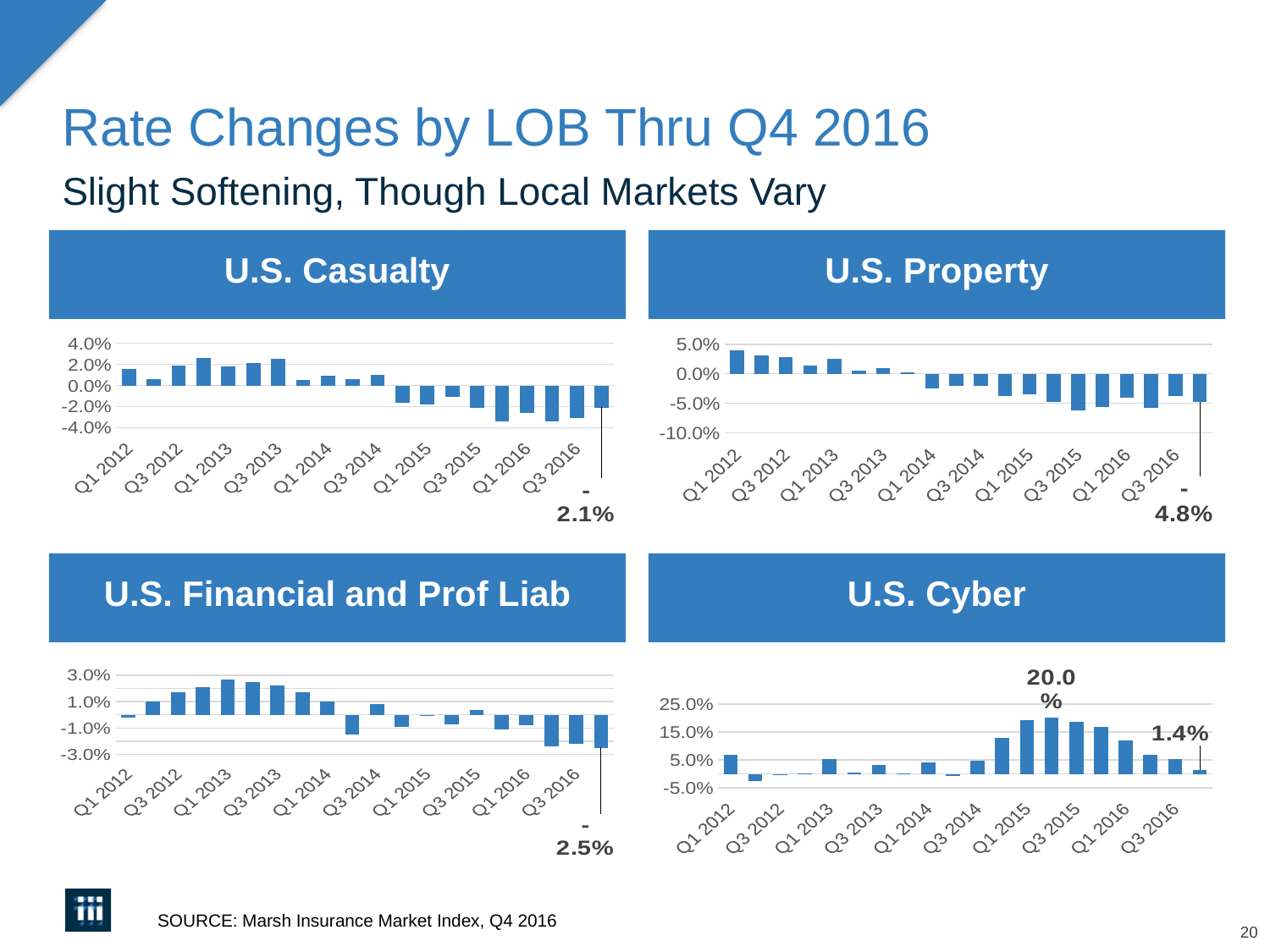
On the U.S. Property chart, what rate change is printed for the final bar (Q4 2016)? -4.8% Which has the lower labeled Q4 2016 rate change, U.S. Casualty or U.S. Property? U.S. Property On the U.S. Cyber chart, what is the value printed above the tallest bar? 20.0% What is the difference between the labeled Q4 2016 rate changes for U.S. Casualty (-2.1%) and U.S. Property (-4.8%)? 2.7% What kind of chart is used for U.S. Casualty? Bar chart On the U.S. Cyber chart, what rate change is printed for the final bar (Q4 2016)? 1.4% On the U.S. Property chart, is the value for Q1 2012 greater or less than 0.0%? greater How many charts are shown on the slide? 4 On the U.S. Cyber chart, do the values rise or fall from Q1 2016 to Q4 2016? fall On the U.S. Financial and Prof Liab chart, what rate change is printed for the final bar (Q4 2016)? -2.5% What source is cited for the charts on the slide? Marsh Insurance Market Index, Q4 2016 On the U.S. Casualty chart, what rate change is printed for the final bar (Q4 2016)? -2.1%